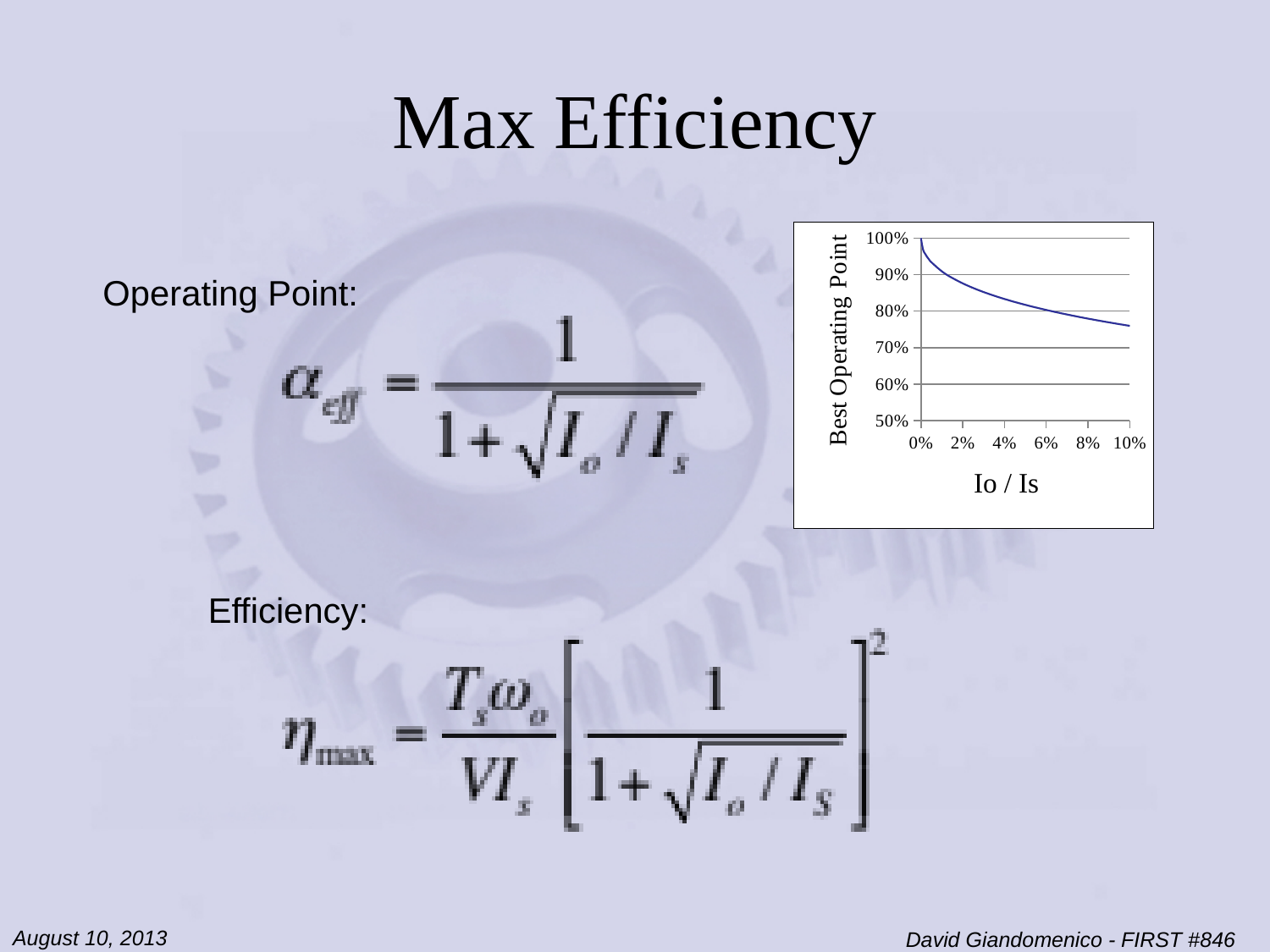
At which Io / Is value shown on the x axis is the Best Operating Point lowest? 10% Is the Best Operating Point at Io / Is = 6% greater or less than 90%? less What kind of chart is shown on the slide? line chart At which Io / Is value shown on the x axis is the Best Operating Point highest? 0% Which is larger, the Best Operating Point at Io / Is = 2% or at Io / Is = 8%? 2% What is the label of the y axis of the chart? Best Operating Point Is the Best Operating Point at Io / Is = 10% greater or less than 80%? less What is the Best Operating Point when Io / Is is 0%? 100% Is the Best Operating Point at Io / Is = 10% greater or less than 70%? greater What is the label of the x axis of the chart? Io / Is Does the Best Operating Point rise or fall as Io / Is increases along the x axis? fall